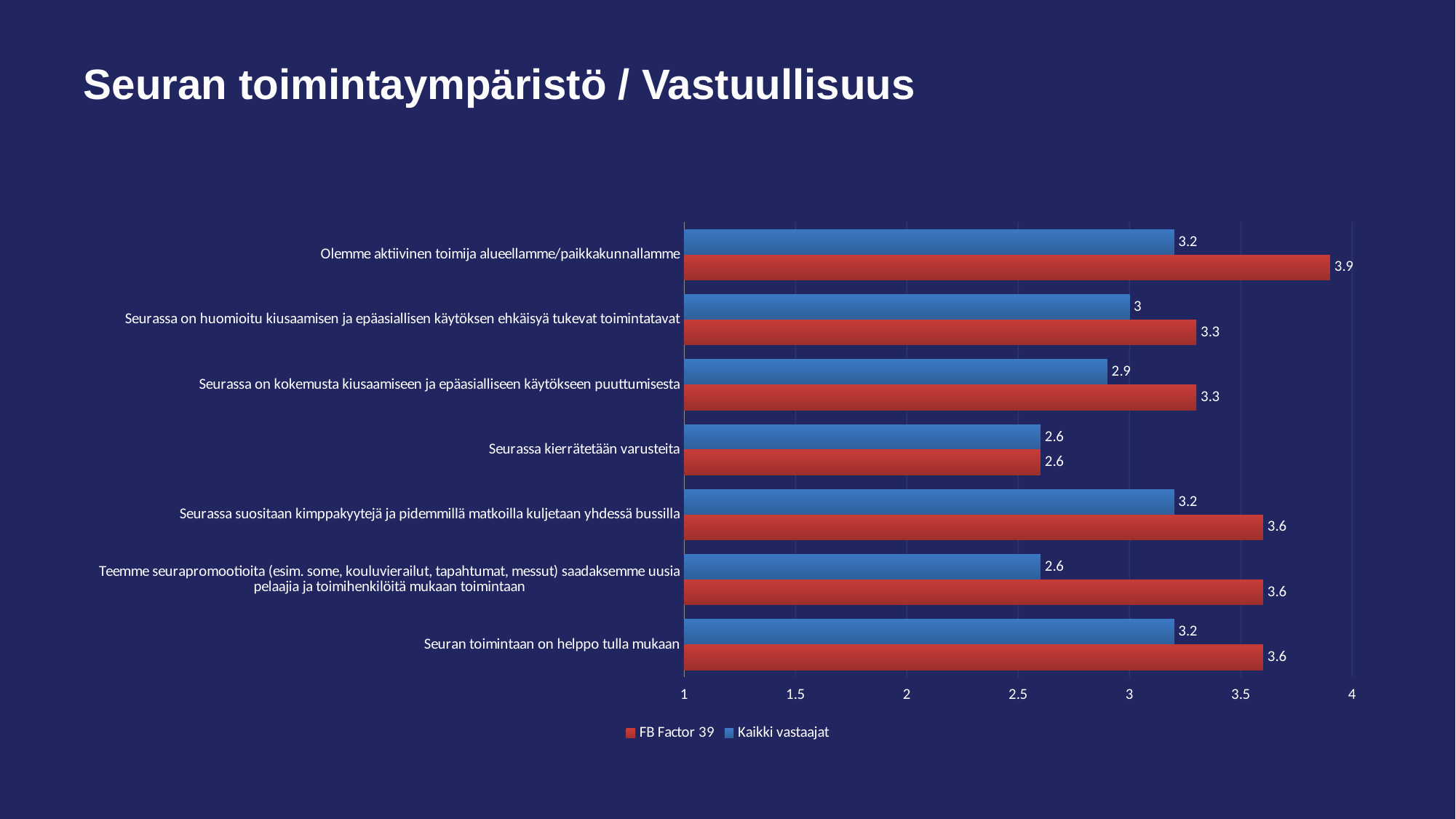
Which colour represents the FB Factor 39 series? Red What kind of chart is shown on the slide? Bar chart Is the FB Factor 39 value for "Seurassa suositaan kimppakyytejä ja pidemmillä matkoilla kuljetaan yhdessä bussilla" greater or less than 3? greater Which is larger for "Seuran toimintaan on helppo tulla mukaan": the FB Factor 39 value or the Kaikki vastaajat value? FB Factor 39 Which category has the lowest FB Factor 39 value? Seurassa kierrätetään varusteita Which category has the highest FB Factor 39 value? Olemme aktiivinen toimija alueellamme/paikkakunnallamme What is the FB Factor 39 value for "Olemme aktiivinen toimija alueellamme/paikkakunnallamme"? 3.9 What is the Kaikki vastaajat value for "Seurassa on huomioitu kiusaamisen ja epäasiallisen käytöksen ehkäisyä tukevat toimintatavat"? 3 How many categories are shown on the chart? 7 What is the Kaikki vastaajat value for "Seurassa on kokemusta kiusaamiseen ja epäasialliseen käytökseen puuttumisesta"? 2.9 What is the difference between the FB Factor 39 and Kaikki vastaajat values for "Teemme seurapromootioita (esim. some, kouluvierailut, tapahtumat, messut) saadaksemme uusia pelaajia ja toimihenkilöitä mukaan toimintaan"? 1 How many series does the legend list? 2